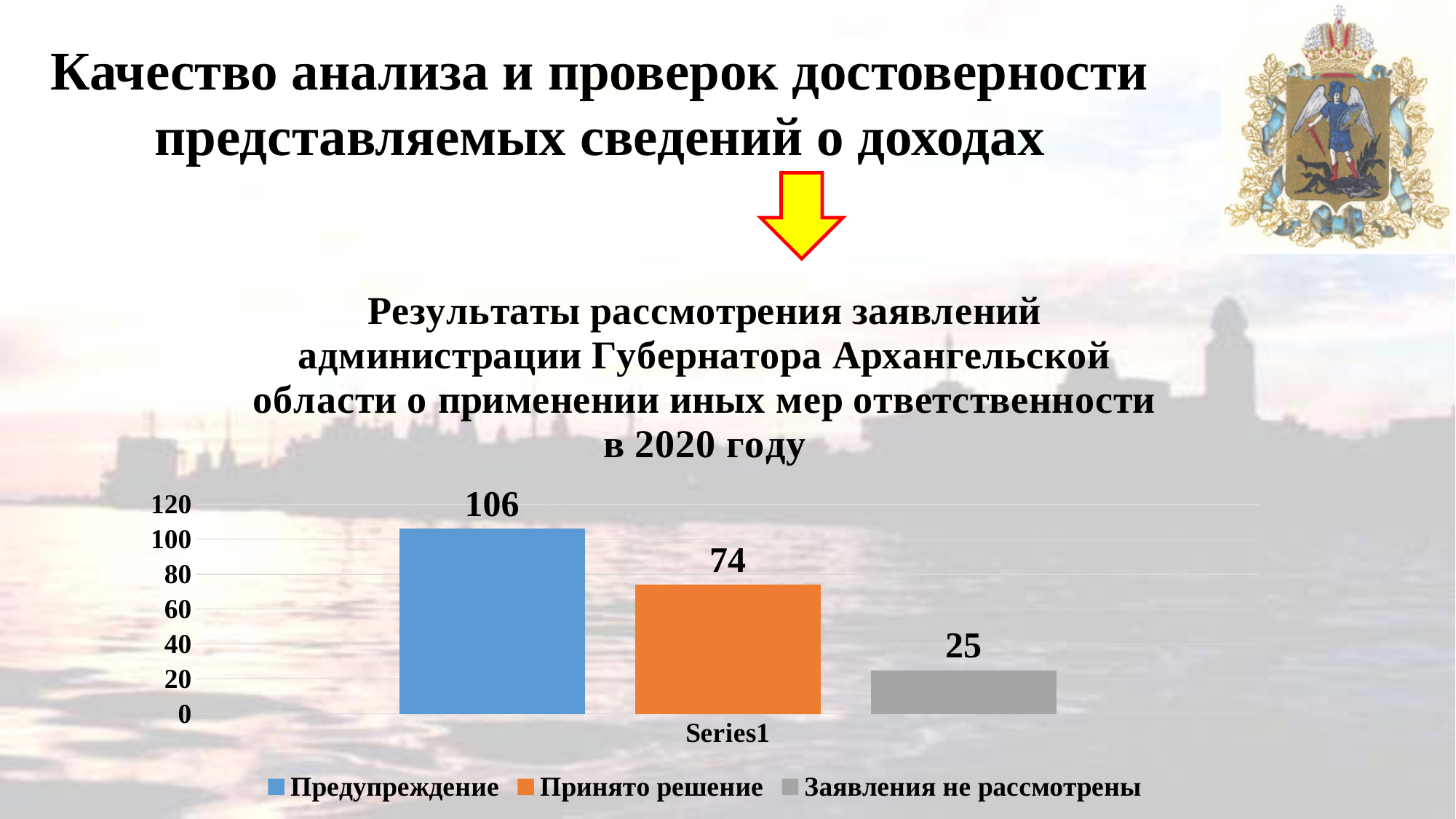
What is the difference between the values for Принято решение and Заявления не рассмотрены? 49 Which is larger, the value for Принято решение or the value for Заявления не рассмотрены? Принято решение Which series has the highest value? Предупреждение What colour is the bar for Принято решение? orange What kind of chart is shown on the slide? bar chart What is the value for Заявления не рассмотрены? 25 Is the value for Предупреждение greater or less than 100? greater What is the value for Предупреждение? 106 Which series has the lowest value? Заявления не рассмотрены What is the difference between the values for Предупреждение and Принято решение? 32 How many series does the legend list? 3 What is the value for Принято решение? 74